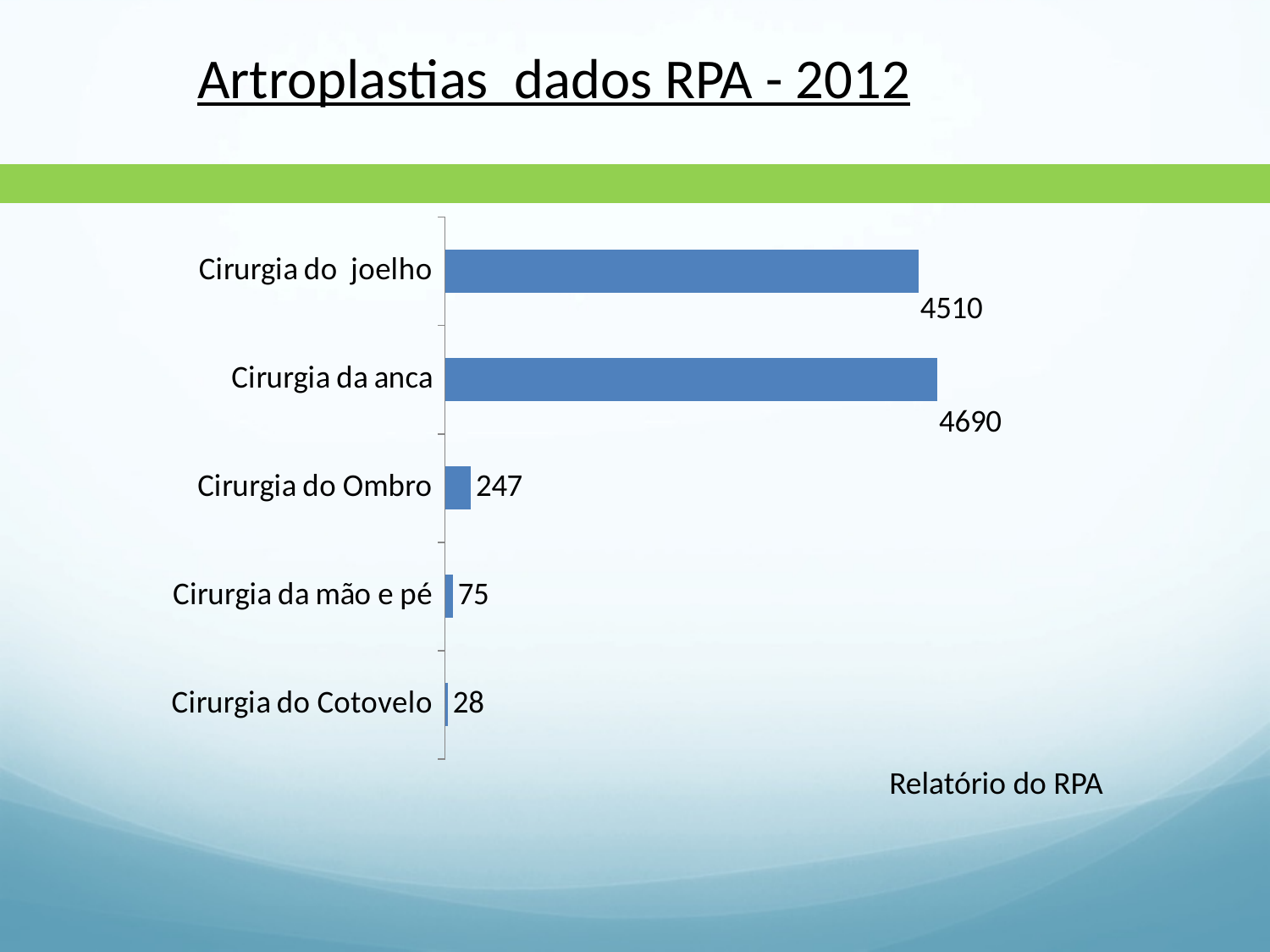
What is the difference between the values for Cirurgia da anca and Cirurgia do joelho? 180 What is the value for Cirurgia do joelho? 4510 Which is larger, the value for Cirurgia do Ombro or the value for Cirurgia do Cotovelo? Cirurgia do Ombro What is the difference between the values for Cirurgia do Ombro and Cirurgia da mão e pé? 172 Which category has the lowest value? Cirurgia do Cotovelo What kind of chart is shown on the slide? Bar chart What is the value for Cirurgia do Cotovelo? 28 How many categories are shown in the chart? 5 What is the value for Cirurgia da mão e pé? 75 What is the value for Cirurgia da anca? 4690 What is the value for Cirurgia do Ombro? 247 Which category has the highest value? Cirurgia da anca